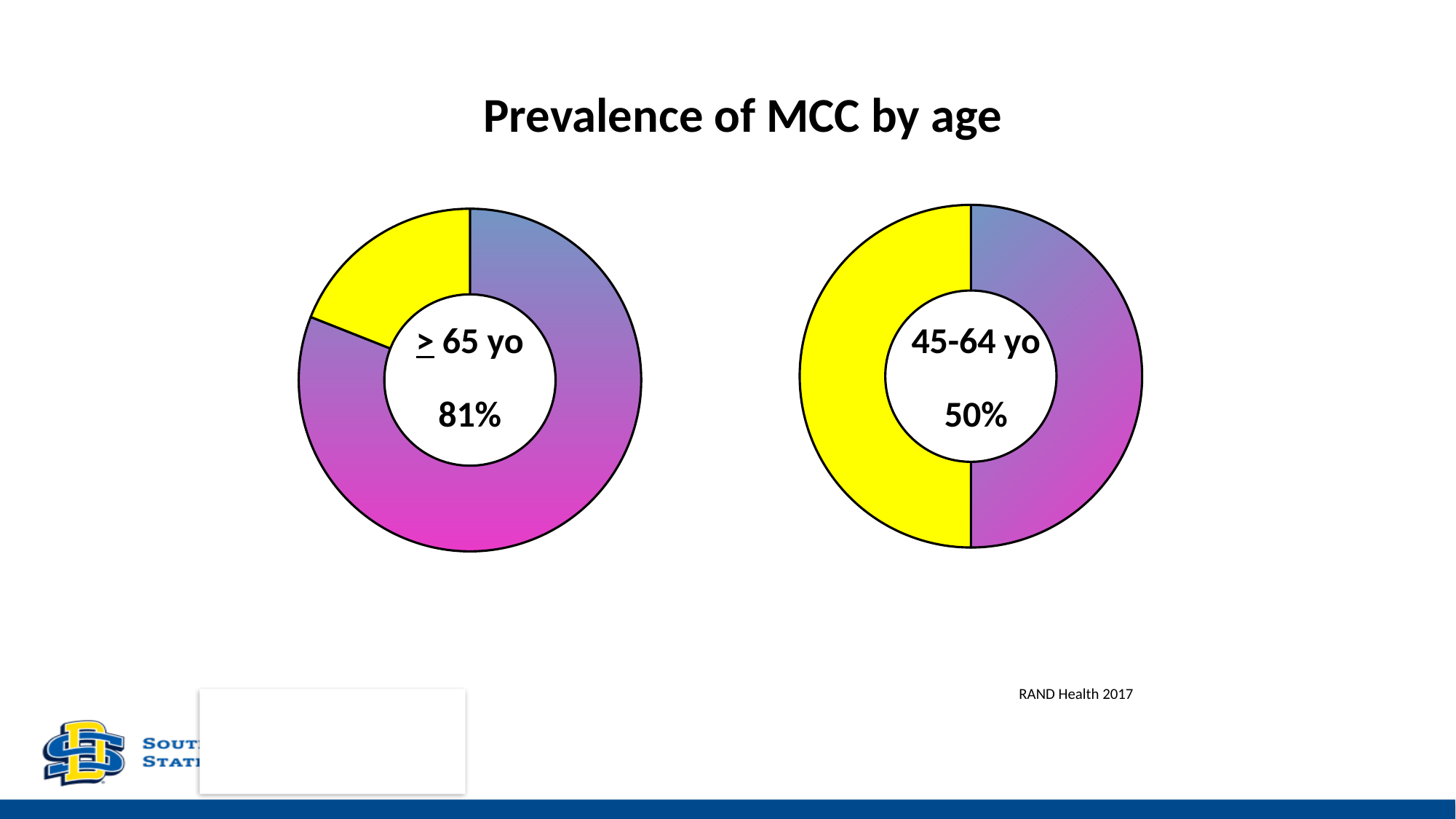
Which age group has the higher prevalence of MCC, ≥ 65 yo or 45-64 yo? ≥ 65 yo How many slices does the 45-64 yo chart have? 2 What is the difference in percentage points between the MCC prevalence for ≥ 65 yo and for 45-64 yo? 31 percentage points What is the title of the slide? Prevalence of MCC by age Which age group shown has the lowest prevalence of MCC? 45-64 yo What kind of chart is used to show the prevalence of MCC for each age group? Doughnut chart What is the prevalence of MCC shown for the ≥ 65 yo group? 81% How many charts are shown on the slide? 2 What source is cited for the charts on the slide? RAND Health 2017 What is the prevalence of MCC shown for the 45-64 yo group? 50% Which age group shown has the highest prevalence of MCC? ≥ 65 yo